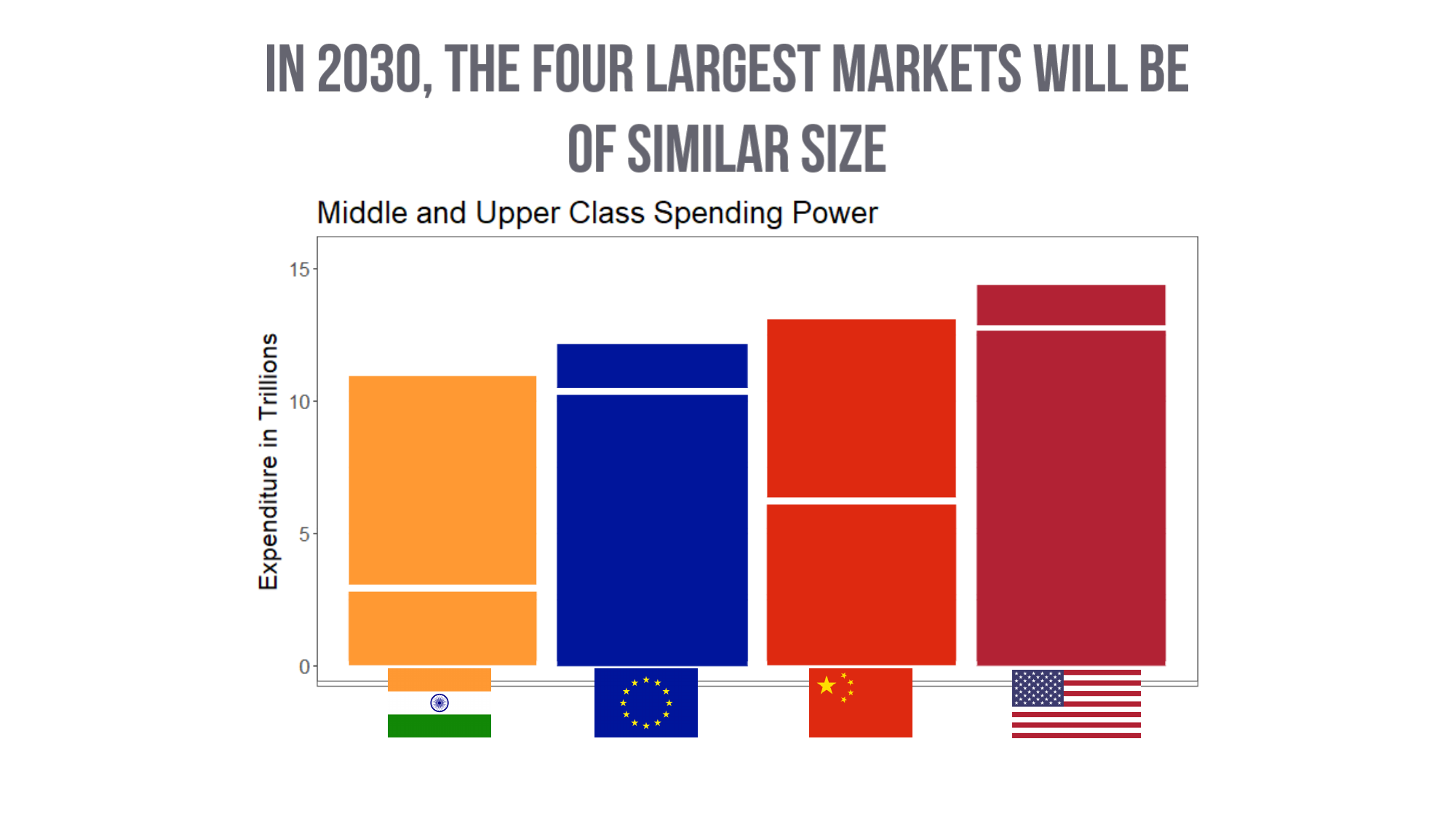
Which market has the tallest bar in the chart? United States (the rightmost bar) Is the lower segment of the India bar greater or less than 5? less How many bars (markets) are shown in the chart? 4 What is the title of the chart? Middle and Upper Class Spending Power Do the bar heights rise or fall moving from left to right across the chart? rise Which bar is taller, the China bar or the EU bar? China Is the lower segment of the China bar greater or less than 5? greater Which market has the shortest bar in the chart? India (the leftmost bar) What is the label on the vertical axis of the chart? Expenditure in Trillions Is the total bar for India greater or less than 10? greater What kind of chart is shown on the slide? bar chart